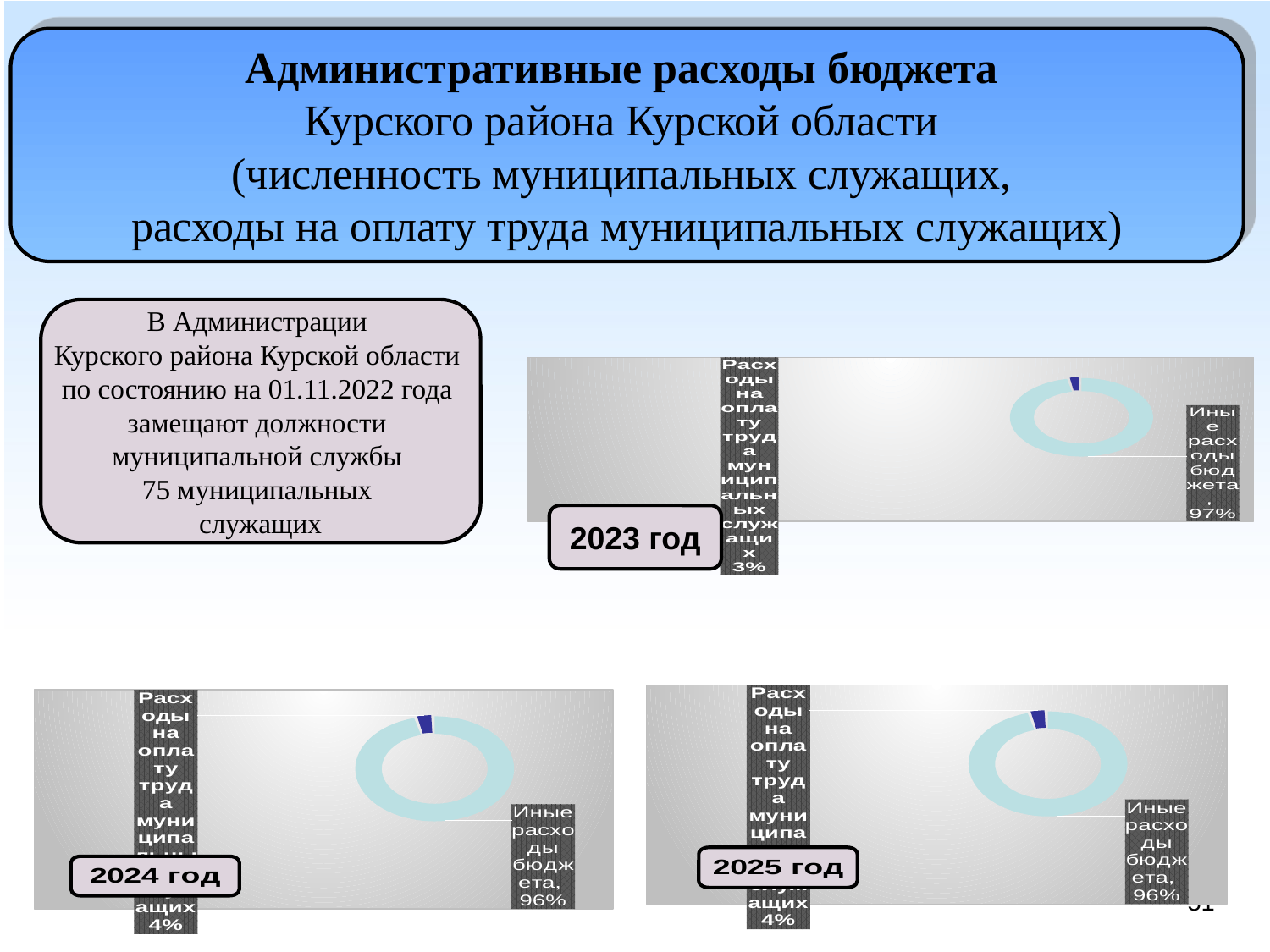
How many charts are shown on the slide? 3 In the 2024 год chart, what is the difference between the shares of Иные расходы бюджета and Расходы на оплату труда муниципальных служащих? 92% In the 2024 год chart, what share is labelled for Расходы на оплату труда муниципальных служащих? 4% In the 2023 год chart, which slice is the largest? Иные расходы бюджета How many slices does the 2025 год chart have? 2 What kind of chart is used for the 2024 год chart? Doughnut (pie) chart In the 2025 год chart, which slice is the smallest? Расходы на оплату труда муниципальных служащих In the 2025 год chart, what share is labelled for Расходы на оплату труда муниципальных служащих? 4% In the 2023 год chart, what share is labelled for Расходы на оплату труда муниципальных служащих? 3% In the 2025 год chart, what share is labelled for Иные расходы бюджета? 96% In the 2024 год chart, what share is labelled for Иные расходы бюджета? 96% In the 2023 год chart, what share is labelled for Иные расходы бюджета? 97%